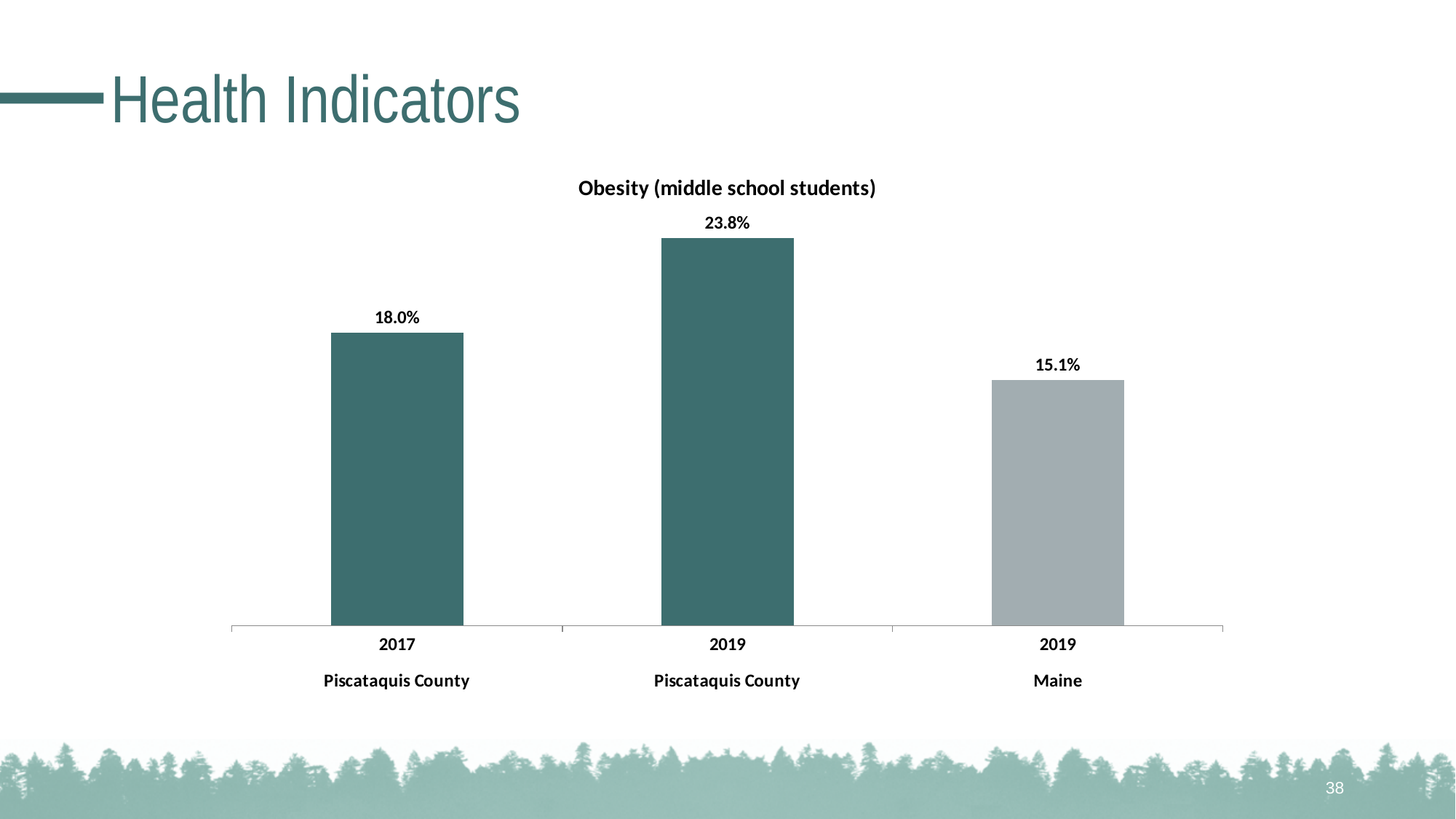
What is the obesity rate for Maine middle school students in 2019? 15.1% What is the obesity rate for Piscataquis County middle school students in 2017? 18.0% Which bar shows the highest obesity rate? Piscataquis County 2019 What is the title of the chart? Obesity (middle school students) Did the Piscataquis County obesity rate rise or fall from 2017 to 2019? Rise What is the difference between the Piscataquis County 2019 rate and the Maine 2019 rate? 8.7 percentage points By how many percentage points did the Piscataquis County obesity rate change from 2017 to 2019? 5.8 percentage points What is the obesity rate for Piscataquis County middle school students in 2019? 23.8% Which bar shows the lowest obesity rate? Maine 2019 What type of chart is shown on the slide? Bar chart In 2019, which had the higher obesity rate, Piscataquis County or Maine? Piscataquis County How many bars are shown in the chart? 3